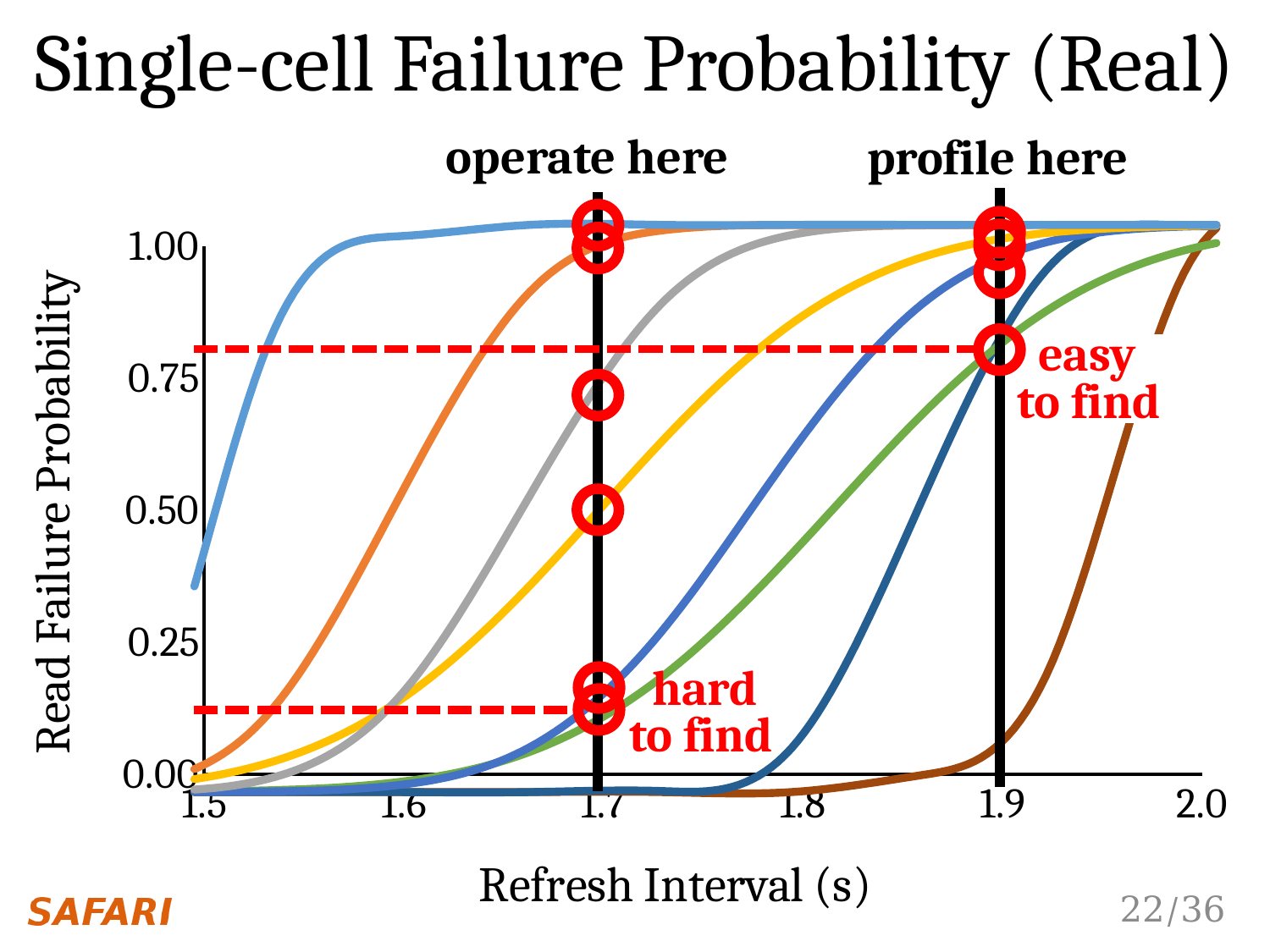
Is the value of the brown curve at a refresh interval of 1.9 s greater or less than 0.25? less At a refresh interval of 1.7 s, which curve has the larger read failure probability, the orange curve or the green curve? orange At which refresh interval is the vertical line labelled "operate here" drawn? 1.7 Is the value of the brown curve at a refresh interval of 2.0 s greater or less than 0.75? greater What kind of chart is shown on the slide? line chart Is the value of the dark blue curve at a refresh interval of 1.7 s greater or less than 0.25? less Do the curves rise or fall as the refresh interval increases along the x axis? rise What is the title of the chart? Single-cell Failure Probability (Real) At a refresh interval of 1.9 s, which curve has the lower read failure probability, the brown curve or the yellow curve? brown How many curves are plotted on the chart? 8